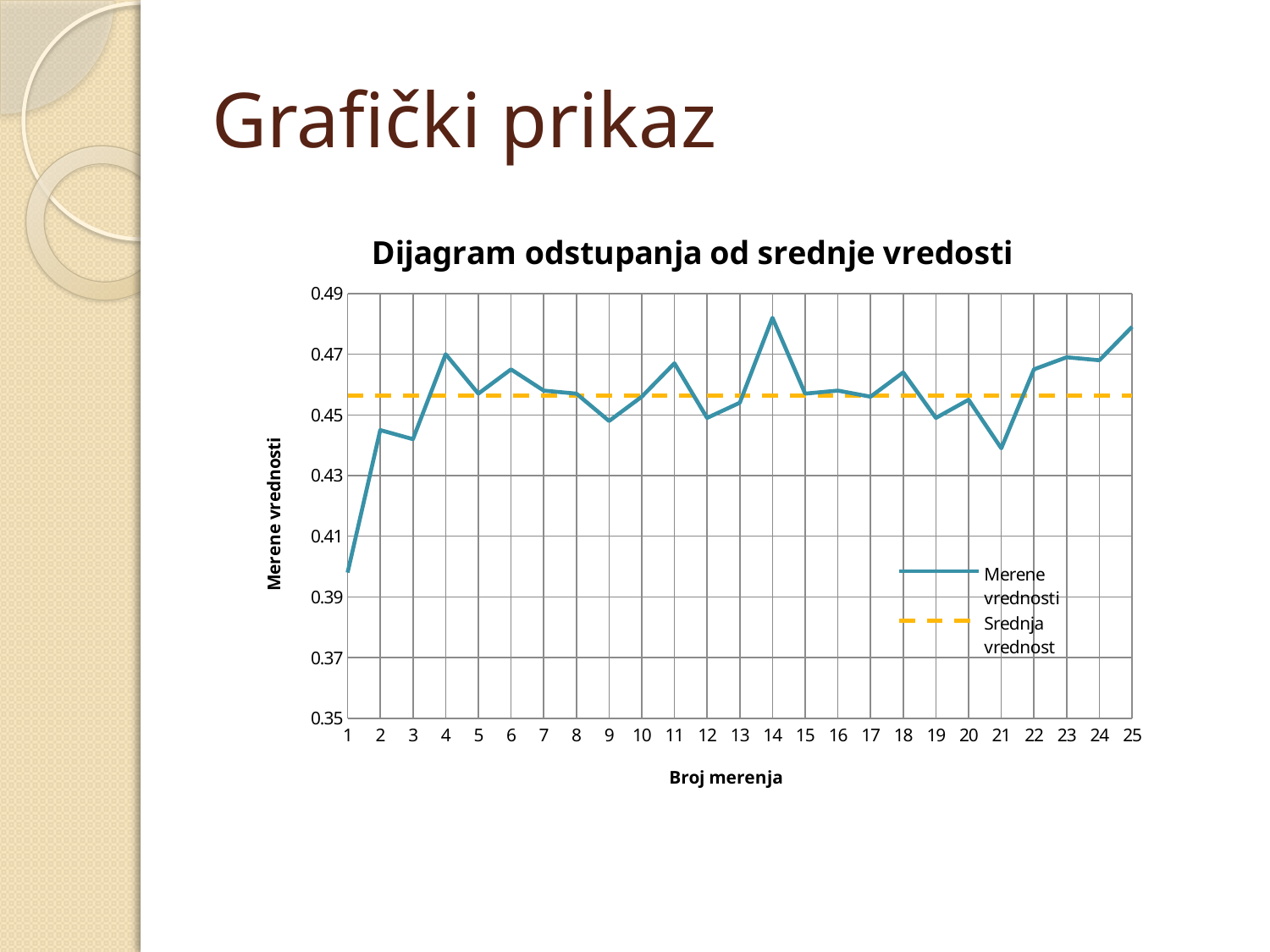
Is the measured value at measurement 14 greater or less than 0.47? greater What kind of chart is shown on the slide? line chart Is the measured value at measurement 1 greater or less than 0.41? less Is the measured value at measurement 21 greater or less than 0.45? less How many measurement points are plotted along the x axis? 25 Do the measured values rise or fall from measurement 1 to measurement 4? rise Which series is drawn with a dashed line? Srednja vrednost How many series does the legend list? 2 What is the title of the chart? Dijagram odstupanja od srednje vredosti Which has the larger measured value, measurement 14 or measurement 21? 14 Which measurement number has the lowest measured value (Merene vrednosti)? 1